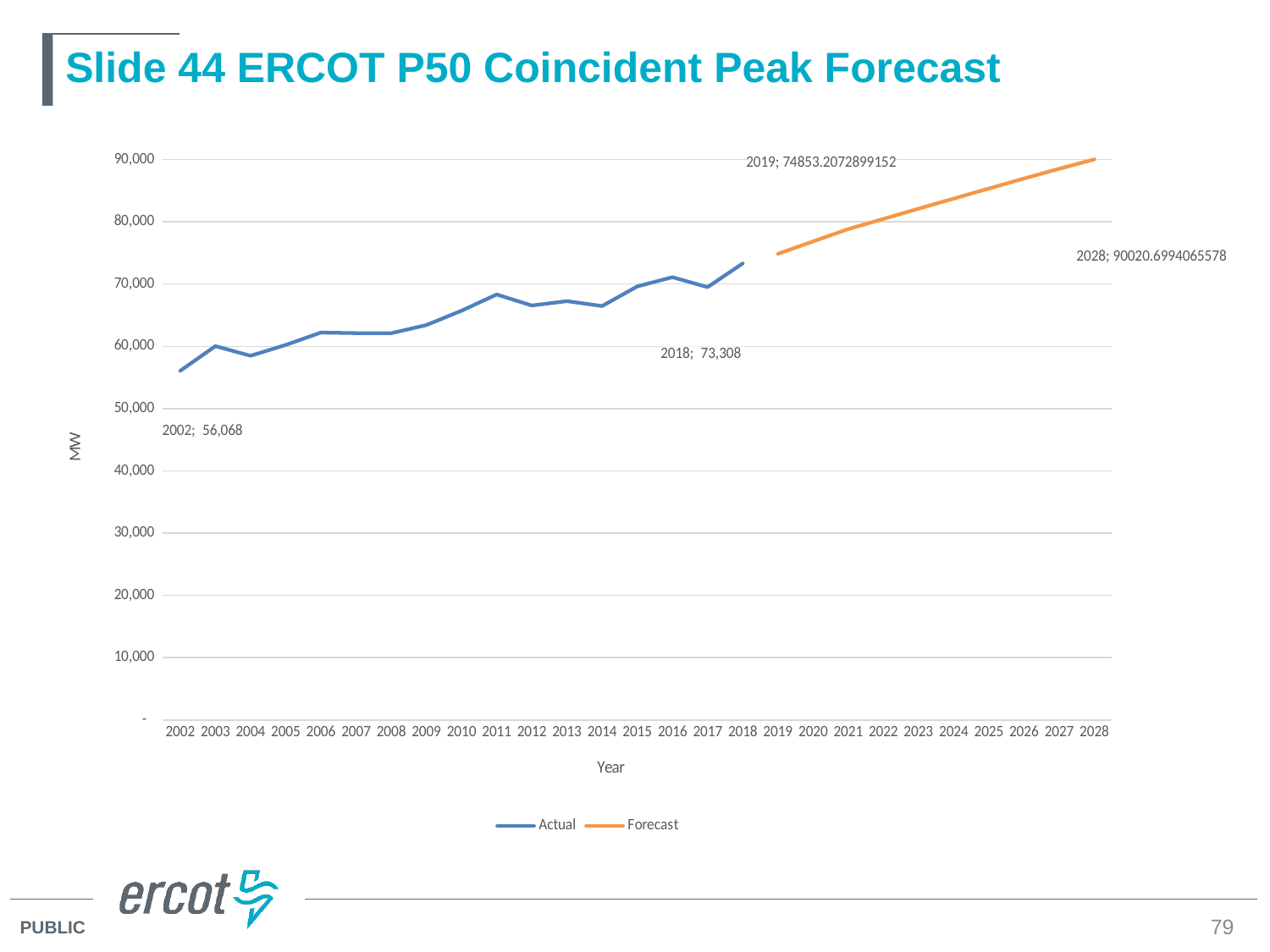
What is the difference between the 2018 value and the 2002 value? 17,240 What is the forecast value labelled for 2028? 90020.6994065578 Which year has the highest value on the chart? 2028 What is the value for 2018 on the Actual series? 73,308 Is the value for 2010 greater or less than 70,000? less How many series does the legend list? 2 What is the value for 2002 on the Actual series? 56,068 Which year has the lowest value on the chart? 2002 What is the forecast value labelled for 2019? 74853.2072899152 Is the value for 2024 greater or less than 80,000? greater What is the label on the y axis? MW What kind of chart is shown on the slide? Line chart